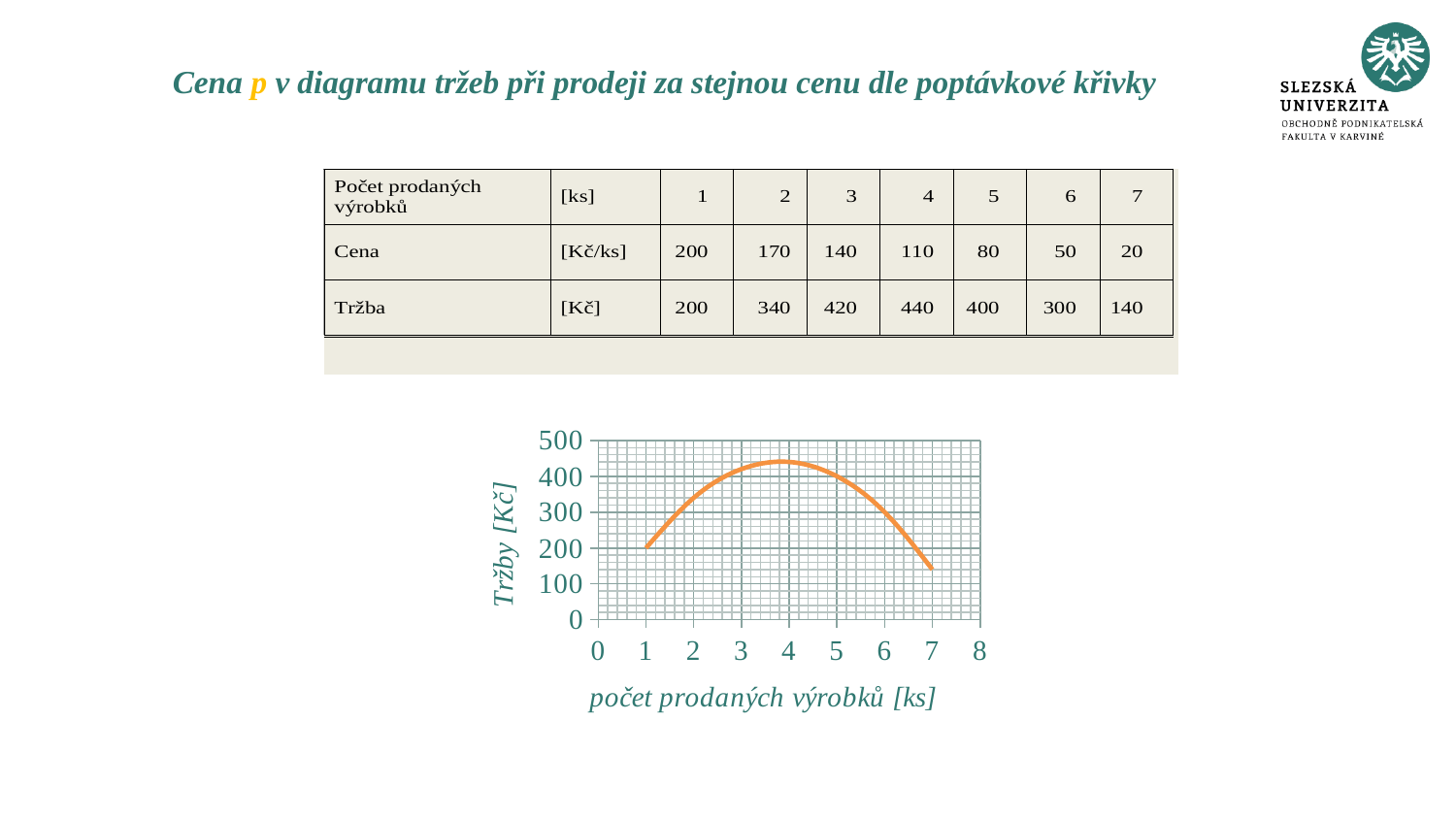
Is the Tržba at 7 sold products greater or less than 200? less According to the table, what is the Cena for 7 sold products? 20 At which number of sold products is the Tržba lowest? 7 What is the label of the x axis of the chart? počet prodaných výrobků [ks] What is the label of the y axis of the chart? Tržby [Kč] According to the table, what is the Tržba for 1 sold product? 200 What is the difference between the Tržba at 4 sold products and at 7 sold products? 300 What kind of chart is shown on the slide? line chart Which is larger, the Tržba at 2 sold products or at 6 sold products? 2 sold products According to the table, what is the Tržba for 4 sold products? 440 At which number of sold products is the Tržba highest? 4 Is the Tržba at 3 sold products greater or less than 400? greater